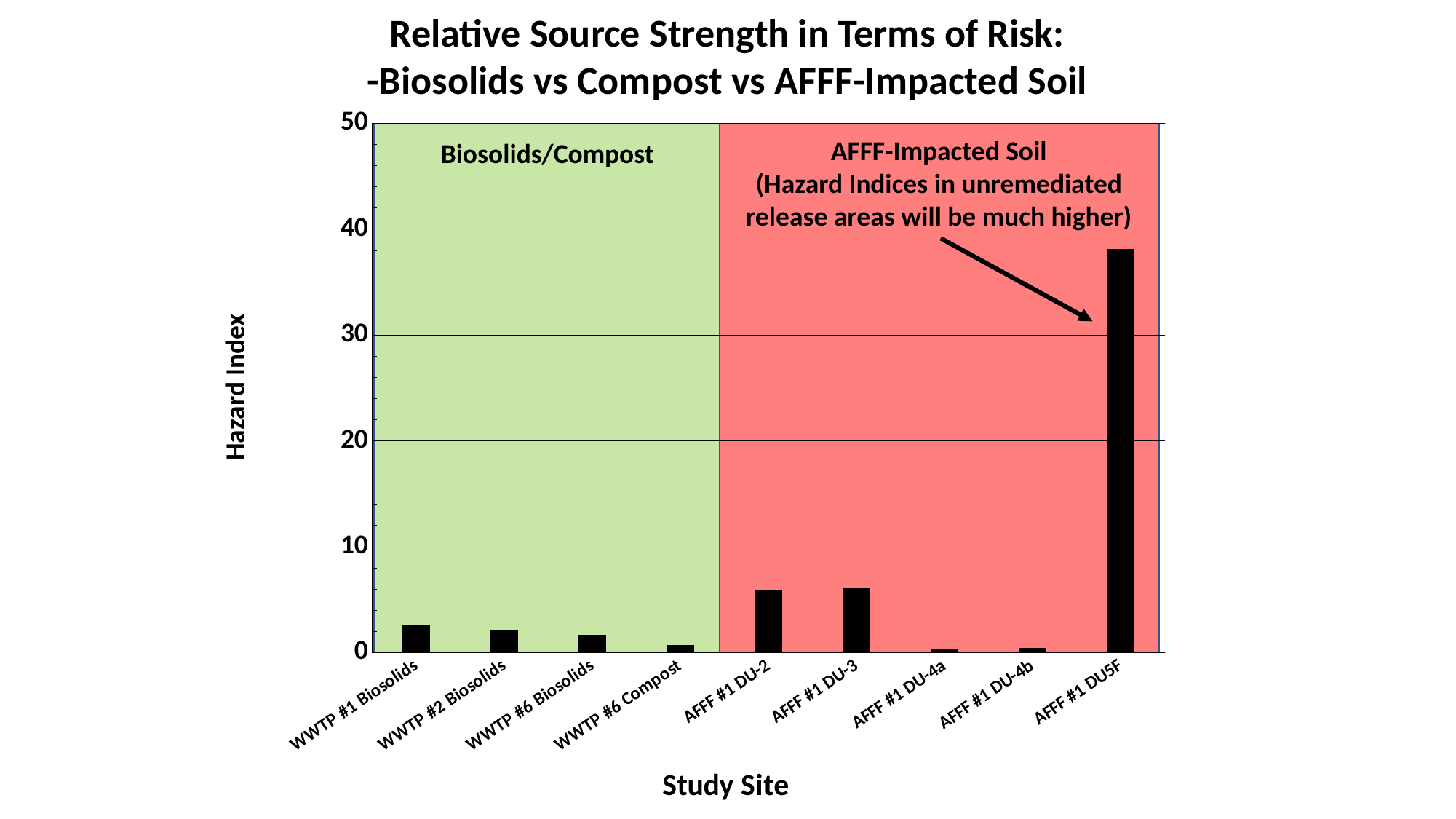
Which study site has the highest Hazard Index? AFFF #1 DU5F Which has a higher Hazard Index, AFFF #1 DU5F or AFFF #1 DU-2? AFFF #1 DU5F Is the Hazard Index for AFFF #1 DU-2 greater or less than 10? less Which has a higher Hazard Index, WWTP #1 Biosolids or WWTP #6 Compost? WWTP #1 Biosolids Is the Hazard Index for WWTP #1 Biosolids greater or less than 10? less Is the Hazard Index for AFFF #1 DU5F greater or less than 40? less What kind of chart is shown on the slide? bar chart How many study sites are plotted on the x axis? 9 What is the label of the x axis? Study Site What is the label of the y axis? Hazard Index Which has a higher Hazard Index, AFFF #1 DU-3 or AFFF #1 DU-4a? AFFF #1 DU-3